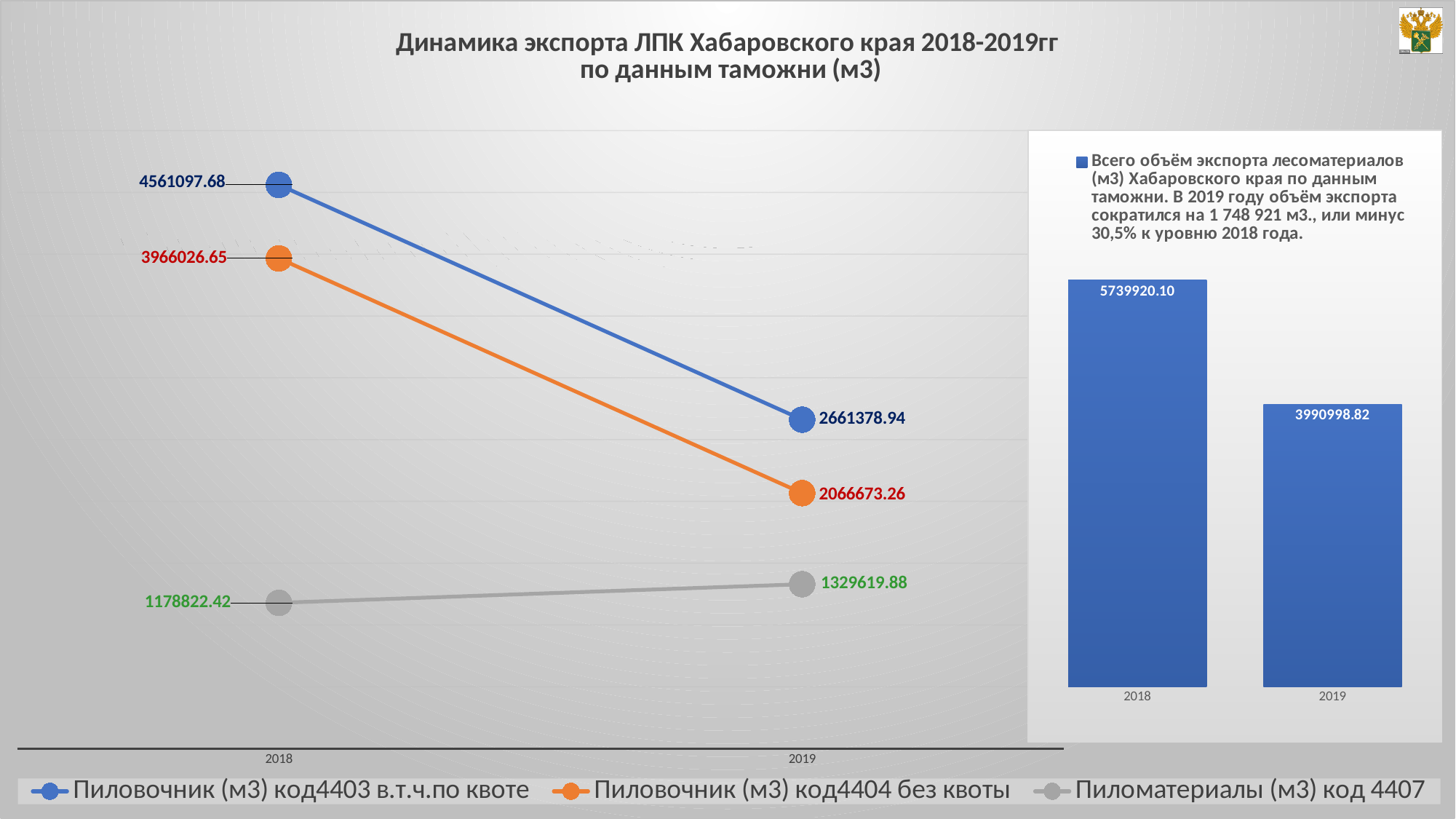
On the line chart on the left, what is the value for Пиловочник (м3) код4404 без квоты in 2019? 2066673.26 On the line chart on the left, which series has the highest value in 2019? Пиловочник (м3) код4403 в.т.ч.по квоте On the line chart on the left, by how much did Пиловочник (м3) код4403 в.т.ч.по квоте decrease from 2018 to 2019? 1899718.74 On the line chart on the left, how many series does the legend list? 3 On the line chart on the left, what is the value for Пиломатериалы (м3) код 4407 in 2019? 1329619.88 On the line chart on the left, does the value for Пиломатериалы (м3) код 4407 rise or fall from 2018 to 2019? rise On the bar chart on the right, what is the value for 2019? 3990998.82 On the line chart on the left, what is the value for Пиловочник (м3) код4403 в.т.ч.по квоте in 2018? 4561097.68 What kind of chart is shown on the right side of the slide? bar chart On the bar chart on the right, what is the value for 2018? 5739920.10 On the bar chart on the right, what is the difference between the 2018 and 2019 values? 1748921.28 On the line chart on the left, which series has the lowest value in 2018? Пиломатериалы (м3) код 4407